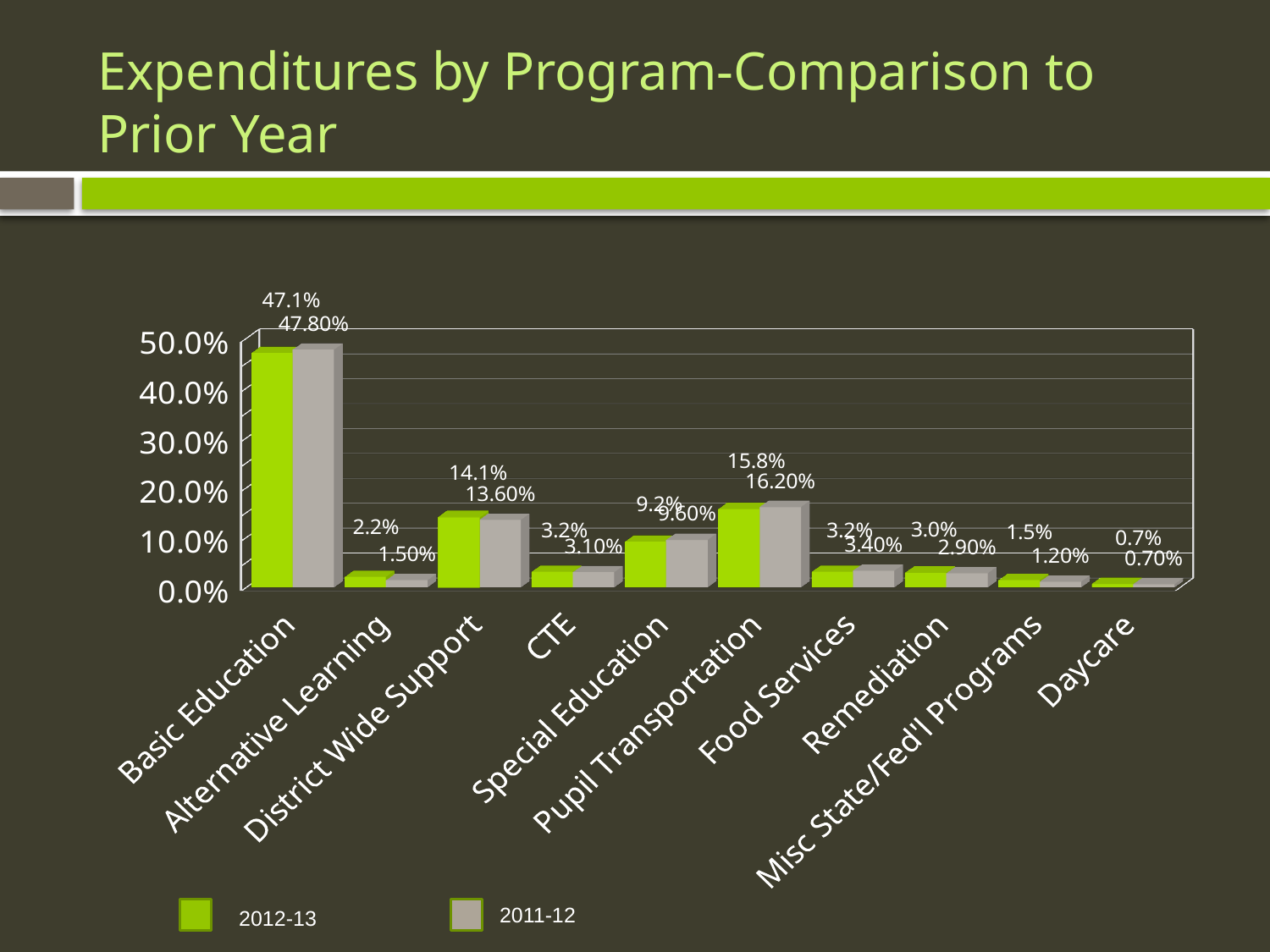
For Pupil Transportation, which is larger: the 2012-13 value or the 2011-12 value? 2011-12 How many programs are shown on the x axis? 10 What kind of chart is shown on the slide? Bar chart What is the 2012-13 value for District Wide Support? 14.1% Which program has the lowest 2011-12 value? Daycare What is the 2011-12 value for Alternative Learning? 1.50% What is the 2012-13 value for Basic Education? 47.1% How many series does the legend list? 2 Which program has the highest 2012-13 value? Basic Education What is the 2011-12 value for Pupil Transportation? 16.20% What is the difference between the 2011-12 and 2012-13 values for Basic Education? 0.7 percentage points Is the 2012-13 value for Special Education greater or less than 10.0%? less